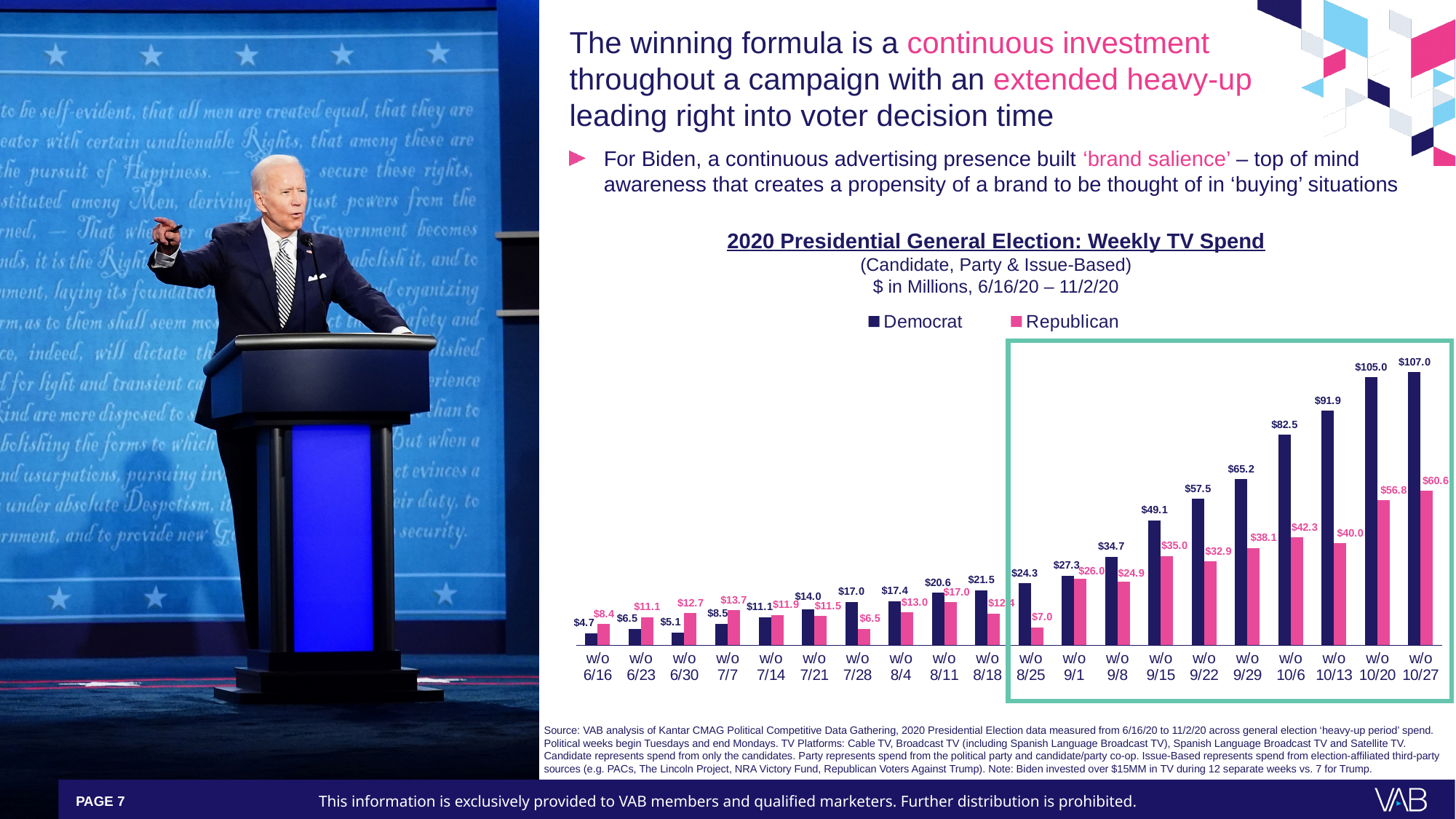
What is the Republican weekly TV spend for the week of 9/15? $35.0 What is the Democrat weekly TV spend for the week of 10/27? $107.0 What kind of chart is used to show the weekly TV spend? Bar chart For the week of 6/23, which party spent more on TV, Democrat or Republican? Republican For the week of 10/6, which party spent more on TV, Democrat or Republican? Democrat Does the Democrat weekly TV spend generally rise or fall from the week of 6/16 to the week of 10/27? Rise For the week of 10/20, how much more did Democrats spend than Republicans? $48.2 How many weeks are shown on the x axis of the chart? 20 Which week has the lowest Democrat TV spend? w/o 6/16 How many series does the chart's legend list? 2 Which week has the lowest Republican TV spend? w/o 7/28 Which week has the highest Democrat TV spend? w/o 10/27